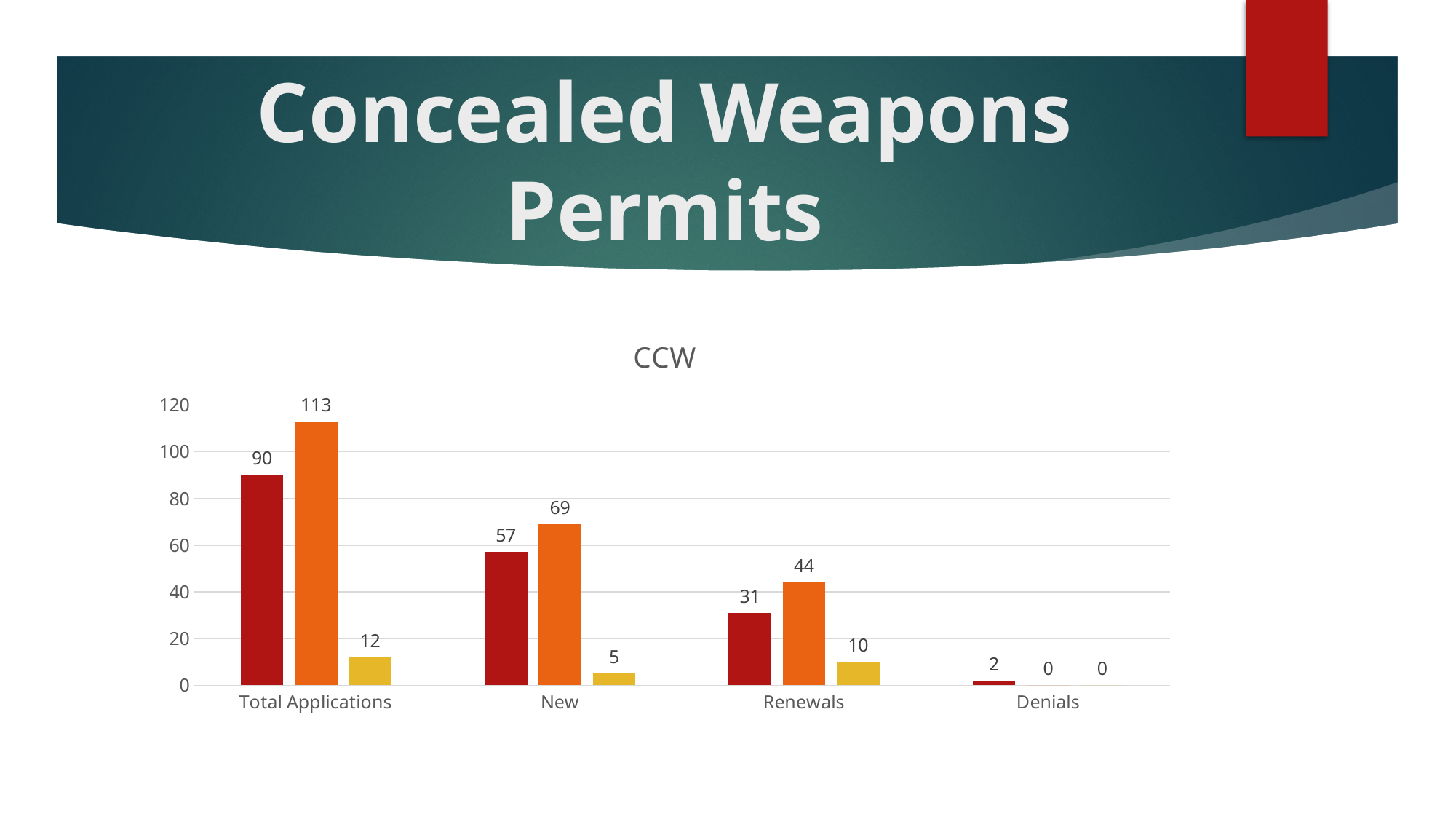
Which is larger for Renewals, the dark red bar or the orange bar? the orange bar Which category has the highest orange bar? Total Applications What is the value of the dark red bar for Denials? 2 What is the difference between the yellow bar for Total Applications and the yellow bar for New? 7 What is the difference between the orange bar and the dark red bar for Total Applications? 23 What is the value of the dark red bar for New? 57 What is the value of the orange bar for Total Applications? 113 What is the title of the chart? CCW What is the value of the yellow bar for Renewals? 10 Which category has the lowest dark red bar? Denials How many categories are shown on the x axis of the chart? 4 What type of chart is shown on the slide? bar chart